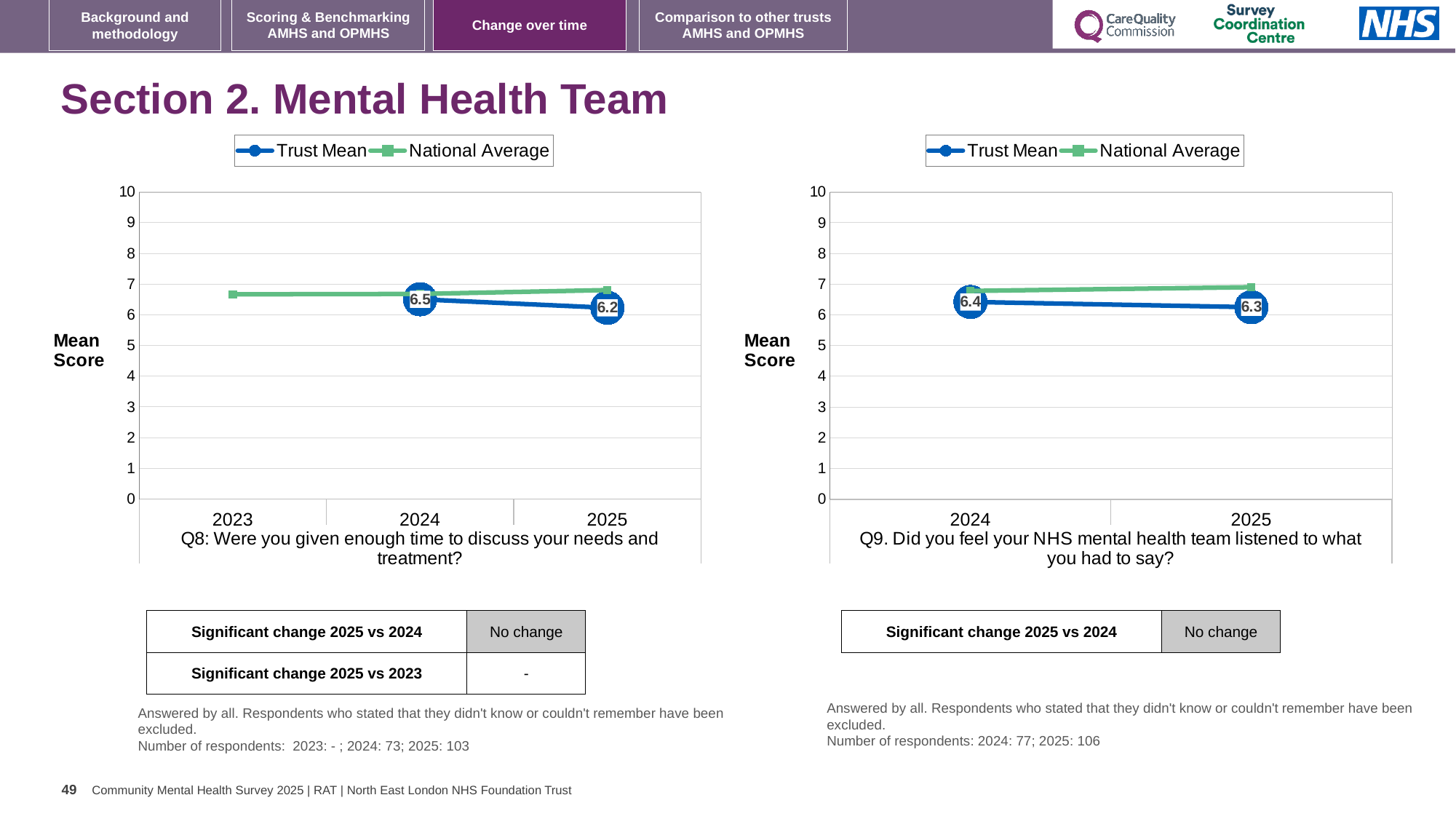
What kind of chart is the Q9 chart (right)? line chart In the Q8 chart (left), which is larger in 2025: the Trust Mean or the National Average? National Average In the Q9 chart (right), what is the Trust Mean for 2025? 6.3 In the Q8 chart (left), does the Trust Mean rise or fall from 2024 to 2025? fall In the Q9 chart (right), is the National Average for 2025 greater or less than 6? greater In the Q9 chart (right), does the National Average rise or fall from 2024 to 2025? rise In the Q9 chart (right), what is the Trust Mean for 2024? 6.4 How many years are shown on the x axis of the Q8 chart (left)? 3 In the Q8 chart (left), by how much did the Trust Mean change from 2024 to 2025? 0.3 In the Q8 chart (left), what is the Trust Mean for 2024? 6.5 In the Q8 chart (left), what is the Trust Mean for 2025? 6.2 How many series does the legend of the Q8 chart (left) list? 2